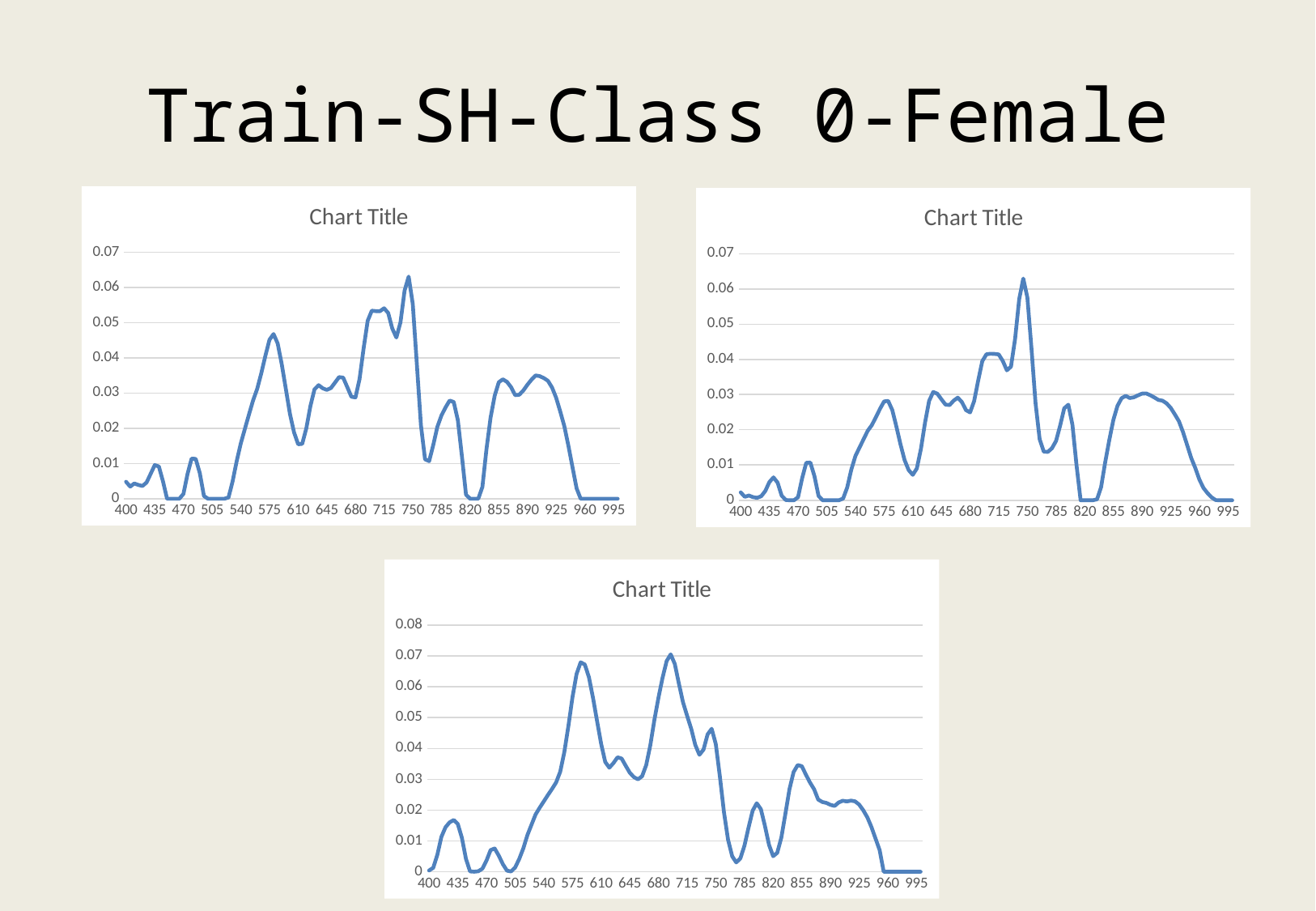
In the top-right chart, is the value at 575 greater or less than 0.02? greater In the top-left chart, is the value at 820 greater or less than 0.01? less How many charts are shown on the slide? 3 What is the title shown on the bottom chart? Chart Title What kind of chart is the top-left chart? line chart In the top-left chart, is the value at 575 greater or less than 0.04? greater In the top-left chart, does the line rise or fall between 540 and 575? rise What is the highest value shown on the y axis of the bottom chart? 0.08